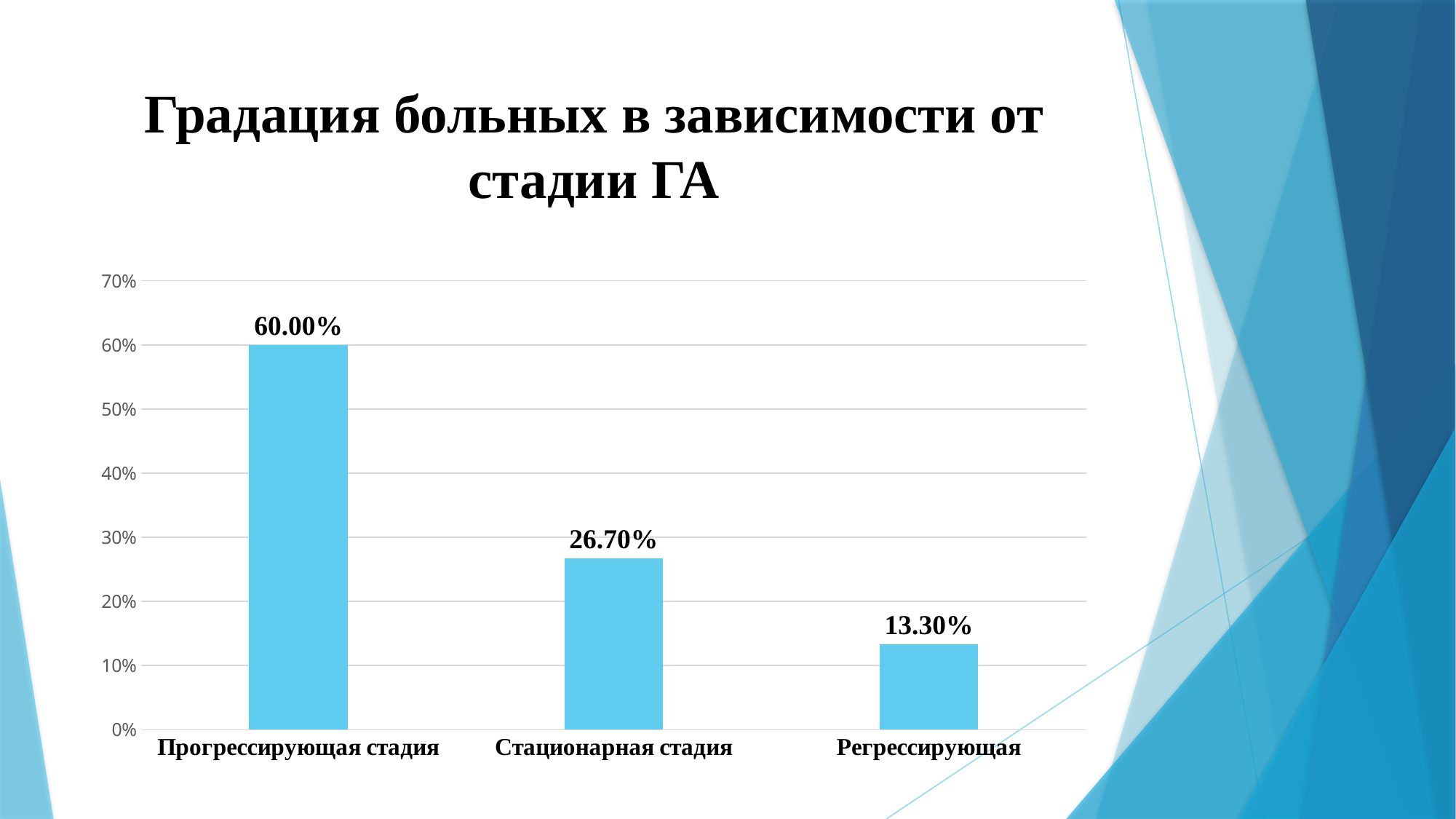
Which category has the highest value? Прогрессирующая стадия How many categories are shown on the chart? 3 What is the value for Регрессирующая? 13.30% Is the value for Стационарная стадия greater or less than 30%? less What kind of chart is shown on the slide? bar chart What is the value for Стационарная стадия? 26.70% Which is larger, the value for Стационарная стадия or the value for Регрессирующая? Стационарная стадия Which category has the lowest value? Регрессирующая What is the title of the chart on the slide? Градация больных в зависимости от стадии ГА What is the difference between the values for Прогрессирующая стадия and Стационарная стадия? 33.30% What is the difference between the values for Стационарная стадия and Регрессирующая? 13.40% What is the value for Прогрессирующая стадия? 60.00%